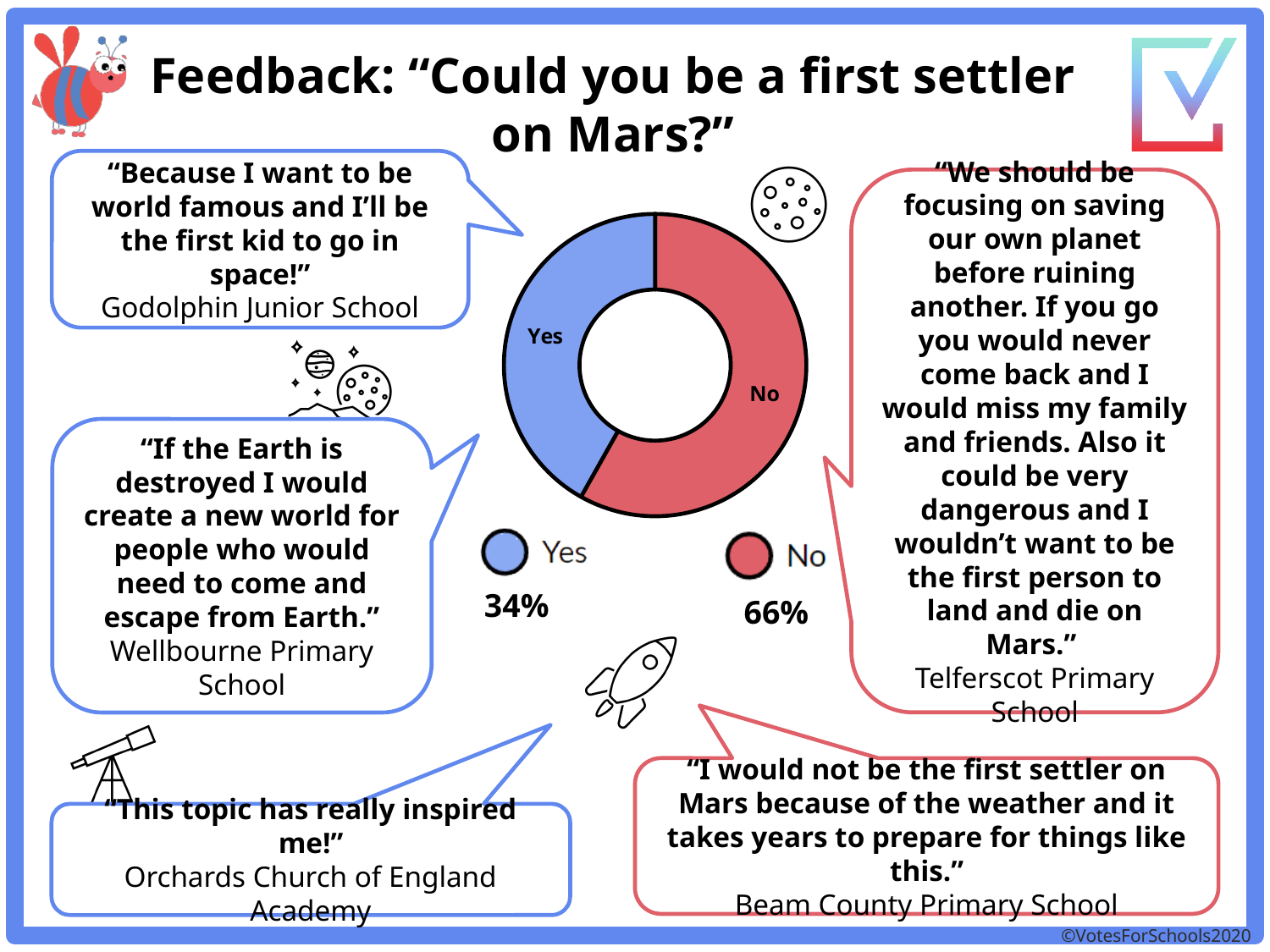
What percentage of respondents answered Yes? 34% What is the difference in percentage points between the No and Yes responses? 32 What share of the pie does the No slice take up? 66% What percentage of respondents answered No? 66% How many categories does the chart show? 2 Which response received the smaller share? Yes What colour represents the No response in the chart? red Which response received the larger share, Yes or No? No What kind of chart is shown on the slide? pie chart (doughnut) Is the share for No greater or less than 50%? greater Is the share for Yes larger or smaller than the share for No? smaller What colour represents the Yes response in the chart? blue